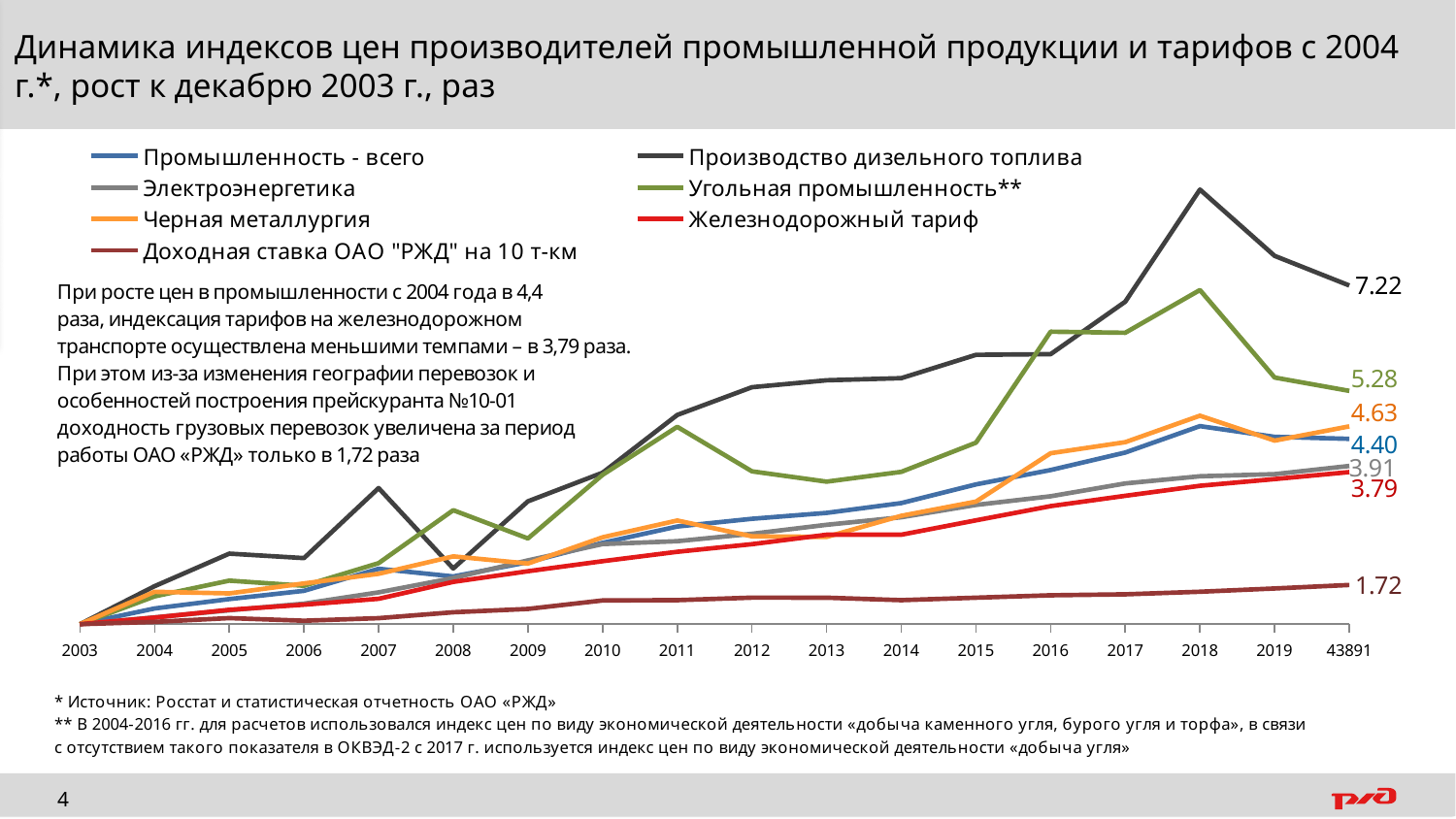
What is the final value shown for the series "Доходная ставка ОАО "РЖД" на 10 т-км"? 1.72 How many series does the legend list? 7 What colour is the line for "Железнодорожный тариф"? red What kind of chart is shown on the slide? line chart Which series has the highest final value on the chart? Производство дизельного топлива Does the series "Доходная ставка ОАО "РЖД" на 10 т-км" generally rise or fall from 2003 to the end of the x axis? rise What is the final value shown for the series "Железнодорожный тариф"? 3.79 What is the difference between the final values of "Производство дизельного топлива" (7.22) and "Железнодорожный тариф" (3.79)? 3.43 What is the final value shown for the series "Угольная промышленность**"? 5.28 Which has the larger final value: "Черная металлургия" or "Промышленность - всего"? Черная металлургия Which series has the lowest final value on the chart? Доходная ставка ОАО "РЖД" на 10 т-км What is the final value shown for the series "Производство дизельного топлива"? 7.22